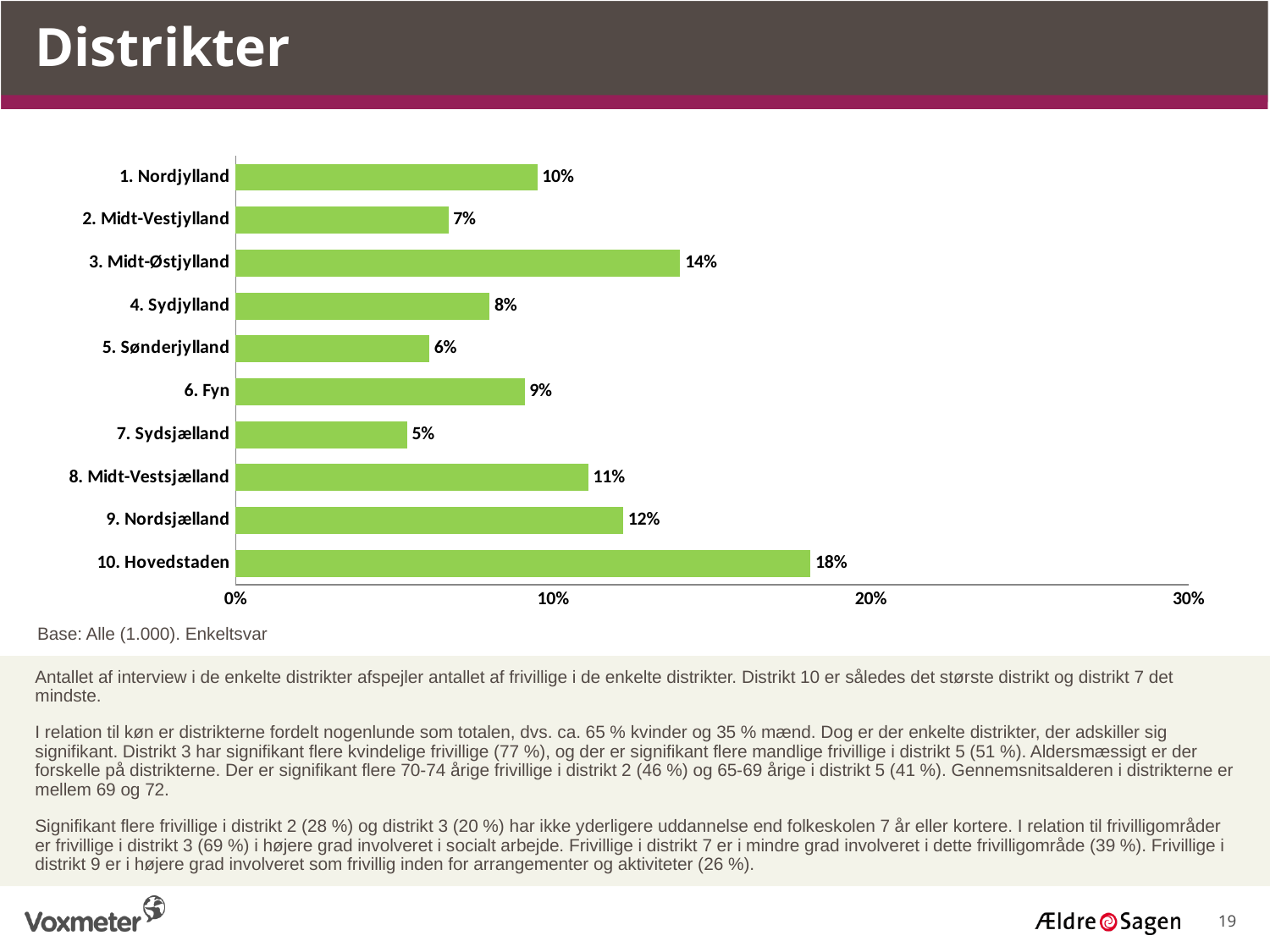
What is the difference between the values for 3. Midt-Østjylland and 5. Sønderjylland? 8% What is the highest value shown on the x axis of the chart? 30% Which district has the lowest value? 7. Sydsjælland Which is larger, the value for 6. Fyn or the value for 4. Sydjylland? 6. Fyn Which district has the highest value? 10. Hovedstaden What is the difference between the values for 10. Hovedstaden and 1. Nordjylland? 8% What is the value for 9. Nordsjælland? 12% What is the value for 7. Sydsjælland? 5% How many districts are shown in the chart? 10 What is the value for 3. Midt-Østjylland? 14% Is the value for 8. Midt-Vestsjælland greater or less than 10%? greater What kind of chart is shown on the slide? Bar chart